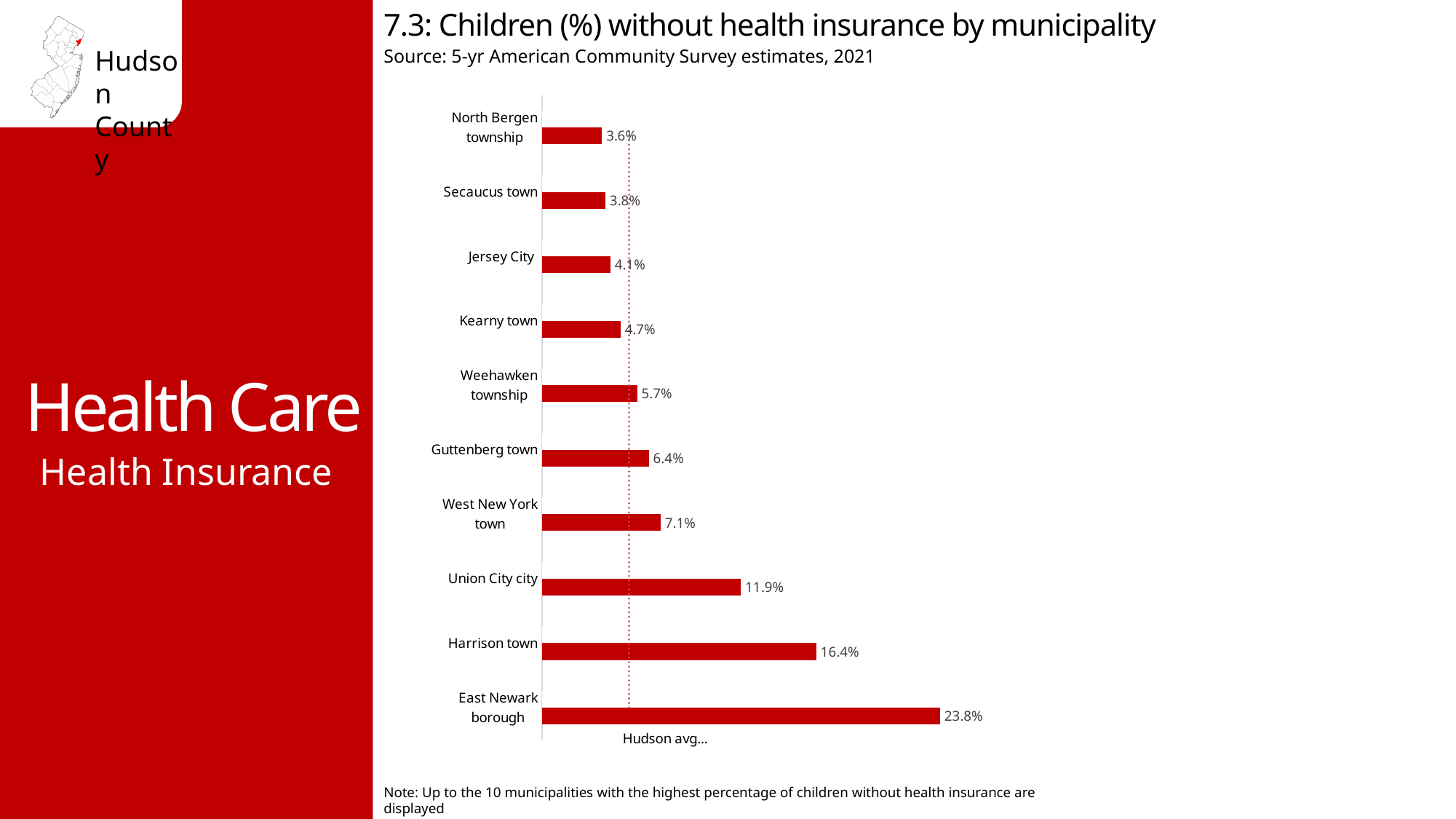
Which municipality has the highest percentage of children without health insurance? East Newark borough Which has a higher value, Kearny town or Secaucus town? Kearny town What is the value shown for Union City city? 11.9% What is the difference between the values for West New York town and Guttenberg town? 0.7% What percentage of children are without health insurance in East Newark borough? 23.8% What type of chart is shown on the slide? Bar chart How many municipalities are shown in the chart? 10 What is the value shown for Weehawken township? 5.7% What does the dotted vertical line on the chart represent? Hudson avg What is the value shown for Jersey City? 4.1% What is the difference between the values for Harrison town and Union City city? 4.5% Which municipality has the lowest percentage of children without health insurance? North Bergen township